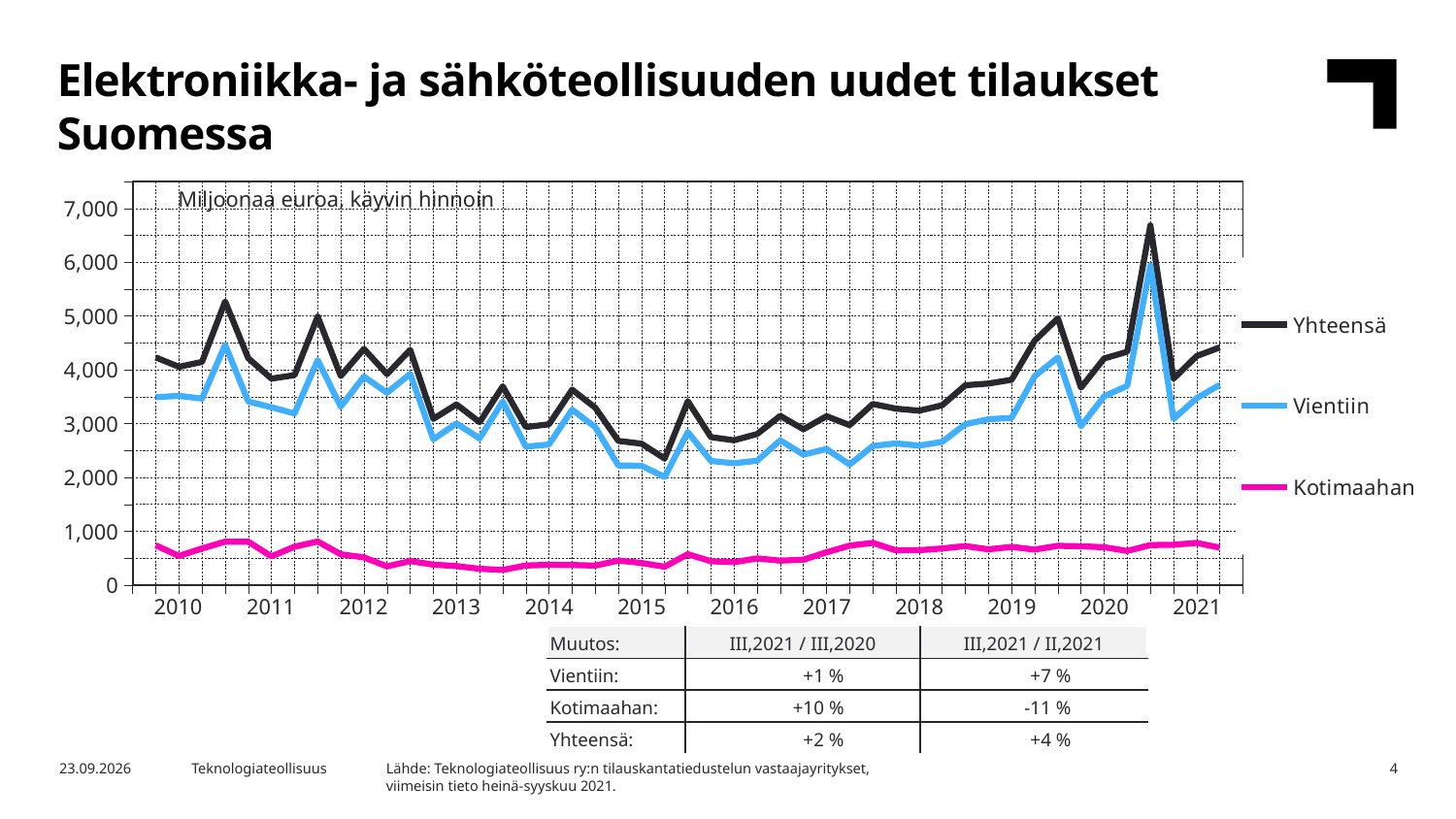
How many year labels are shown on the x axis? 12 Is the value for Vientiin at the start of 2010 greater or less than 3,000? greater Is the value for Kotimaahan in 2021 greater or less than 1,000? less What kind of chart is shown on the slide? line chart Which is larger in 2021, the value for Vientiin or the value for Kotimaahan? Vientiin Between 2018 and 2019, does the Yhteensä line generally rise or fall? rise Is the peak value for Yhteensä in 2020 greater or less than 6,000? greater How many series does the legend list? 3 Which series has the lowest values throughout the chart? Kotimaahan What are the three series named in the legend? Yhteensä, Vientiin, Kotimaahan What unit label is printed inside the chart area? Miljoonaa euroa, käyvin hinnoin Which series has the highest values throughout the chart? Yhteensä